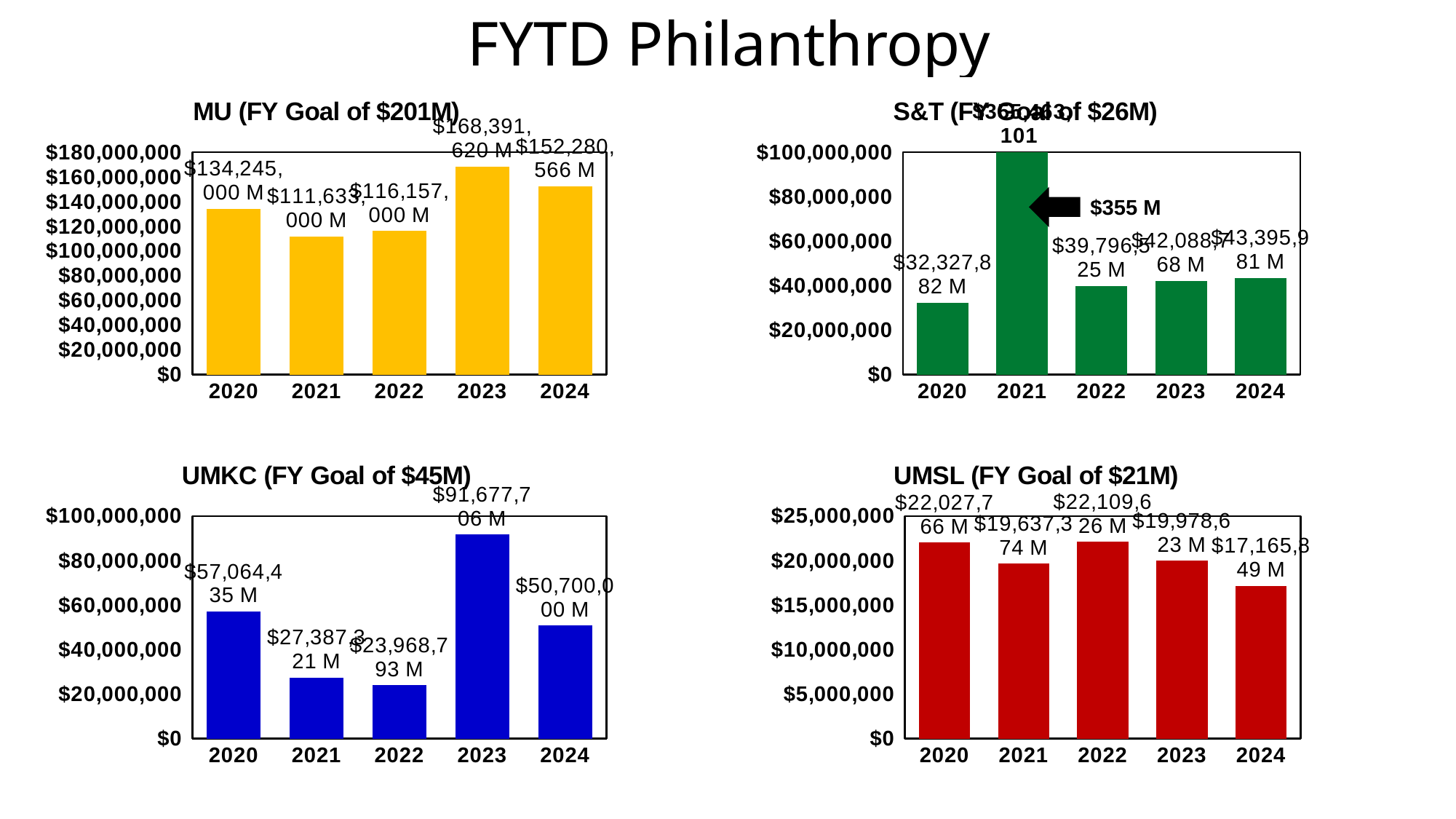
How many years are shown on the UMSL (FY Goal of $21M) chart? 5 On the UMKC (FY Goal of $45M) chart, which year has the lowest value? 2022 On the UMKC (FY Goal of $45M) chart, what is the value for 2024? $50,700,000 M On the MU (FY Goal of $201M) chart, which year has the highest value? 2023 On the UMSL (FY Goal of $21M) chart, which year has the lowest value? 2024 On the MU (FY Goal of $201M) chart, what is the value for 2023? $168,391,620 M On the S&T (FY Goal of $26M) chart, what is the value for 2024? $43,395,981 M On the UMSL (FY Goal of $21M) chart, what is the difference between the 2020 value and the 2024 value? $4,861,917 On the S&T (FY Goal of $26M) chart, do the values rise or fall from 2022 to 2024? rise On the UMKC (FY Goal of $45M) chart, is the value for 2023 greater or less than $80,000,000? greater On the S&T (FY Goal of $26M) chart, which year has the highest value? 2021 On the MU (FY Goal of $201M) chart, is the value for 2021 greater or less than $120,000,000? less